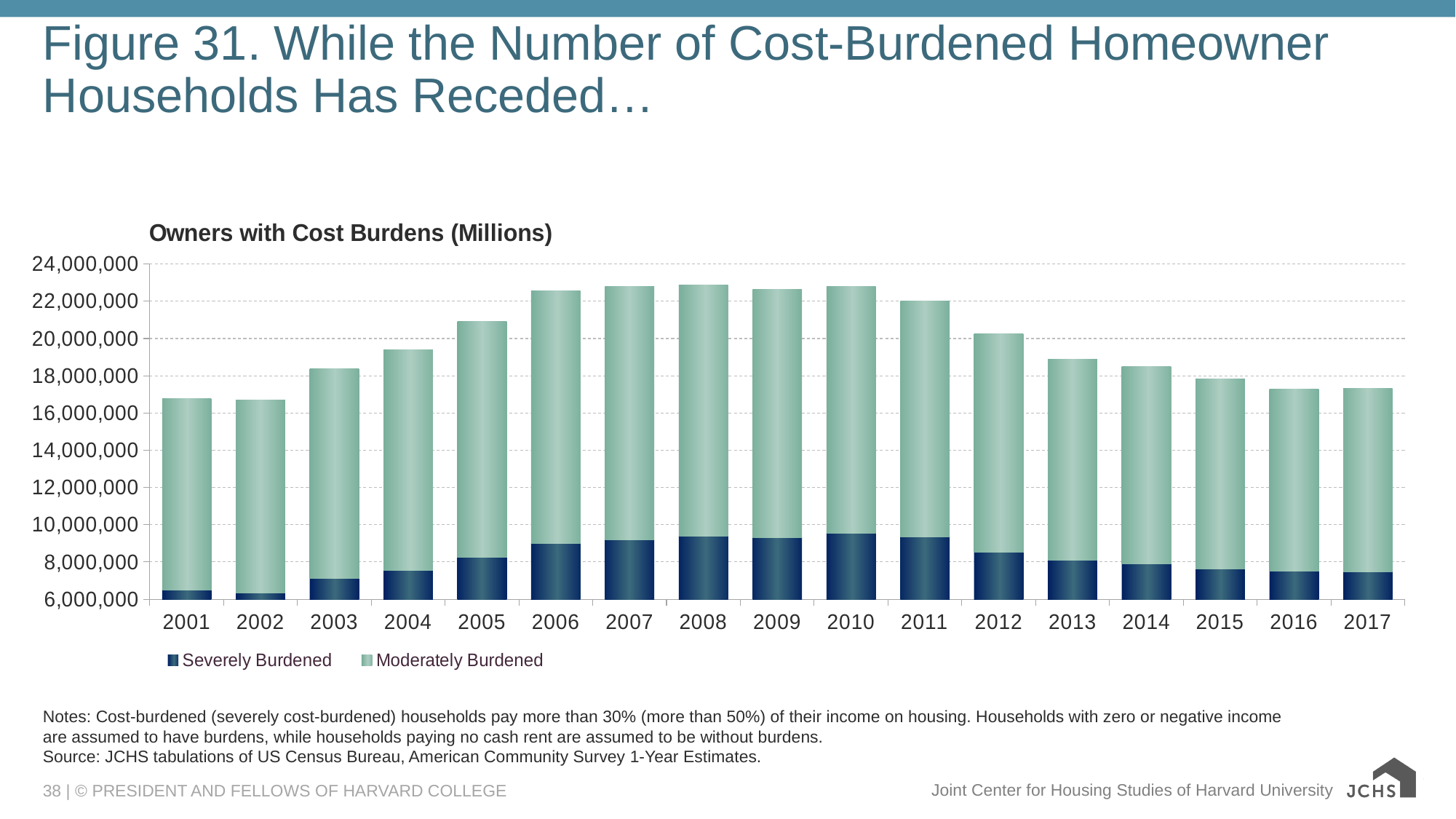
Do the total bars rise or fall from 2010 to 2017? fall How many series does the chart's legend list? 2 Which year has the larger total of cost-burdened owners, 2011 or 2012? 2011 What kind of chart is shown on the slide? Stacked bar chart Is the total number of cost-burdened owners in 2001 greater or less than 18,000,000? less Which year has the larger total of cost-burdened owners, 2008 or 2001? 2008 What is the title printed above the chart? Owners with Cost Burdens (Millions) Is the number of severely burdened owners in 2002 greater or less than 8,000,000? less Is the number of severely burdened owners in 2010 greater or less than 8,000,000? greater How many years are shown along the x axis of the chart? 17 What are the two series named in the legend? Severely Burdened and Moderately Burdened